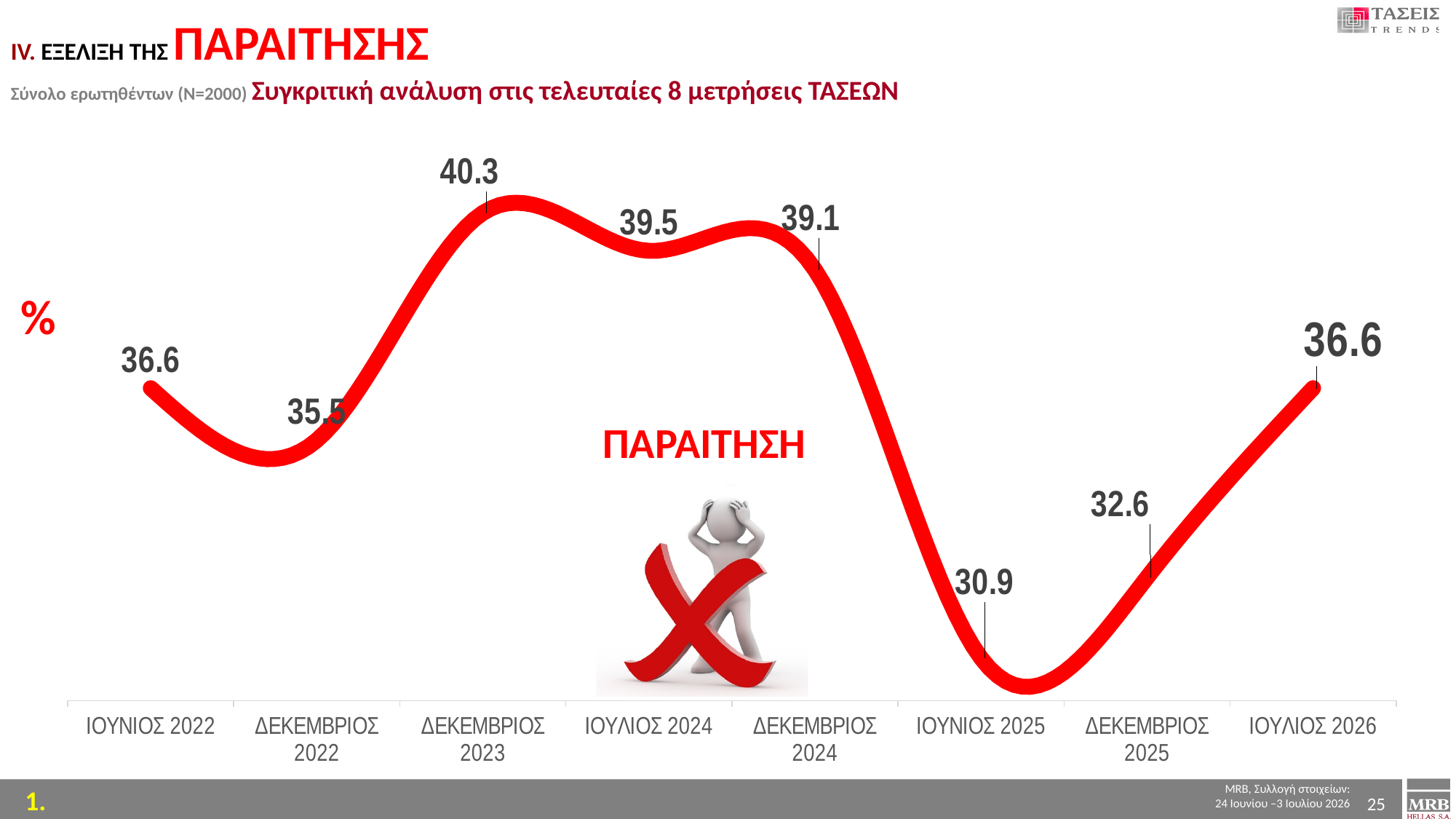
What is the difference between the highest value (ΔΕΚΕΜΒΡΙΟΣ 2023) and the lowest value (ΙΟΥΝΙΟΣ 2025)? 9.4 Does the value rise or fall from ΔΕΚΕΜΒΡΙΟΣ 2024 to ΙΟΥΝΙΟΣ 2025? Fall Which is larger, the value for ΙΟΥΛΙΟΣ 2024 or the value for ΔΕΚΕΜΒΡΙΟΣ 2025? ΙΟΥΛΙΟΣ 2024 What kind of chart is shown on the slide? Line chart Which measurement has the highest value? ΔΕΚΕΜΒΡΙΟΣ 2023 What is the value for ΙΟΥΛΙΟΣ 2026? 36.6 What is the difference between the values for ΔΕΚΕΜΒΡΙΟΣ 2025 and ΙΟΥΝΙΟΣ 2025? 1.7 What is the value for ΔΕΚΕΜΒΡΙΟΣ 2022? 35.5 What is the value for ΙΟΥΝΙΟΣ 2025? 30.9 Which measurement has the lowest value? ΙΟΥΝΙΟΣ 2025 What is the value for ΔΕΚΕΜΒΡΙΟΣ 2023? 40.3 How many measurement points are plotted on the chart? 8